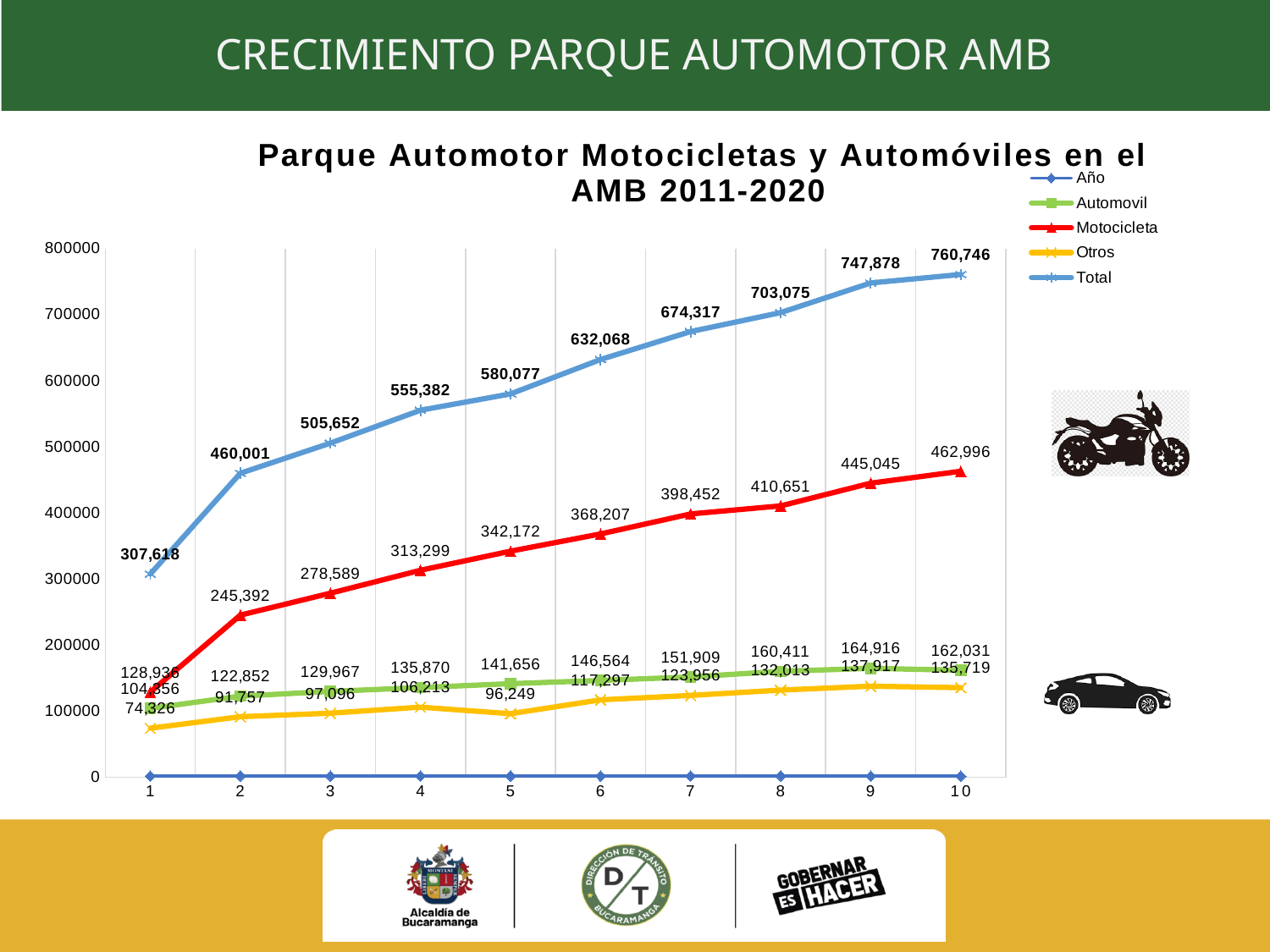
How many series does the legend list? 5 What is the value of the Otros series at point 1? 74,326 Is the value of the Motocicleta series at point 2 greater or less than 300000? less What is the value of the Motocicleta series at point 5? 342,172 What is the value of the Total series at point 10? 760,746 What is the difference between the Total values at point 10 and point 9? 12,868 At which x-axis point is the Total series highest? 10 At which x-axis point is the Otros series lowest? 1 What is the value of the Automovil series at point 8? 160,411 At point 5, which series has the larger value, Automovil or Otros? Automovil What kind of chart is shown on the slide? line chart How many points are plotted along the x axis for each series? 10